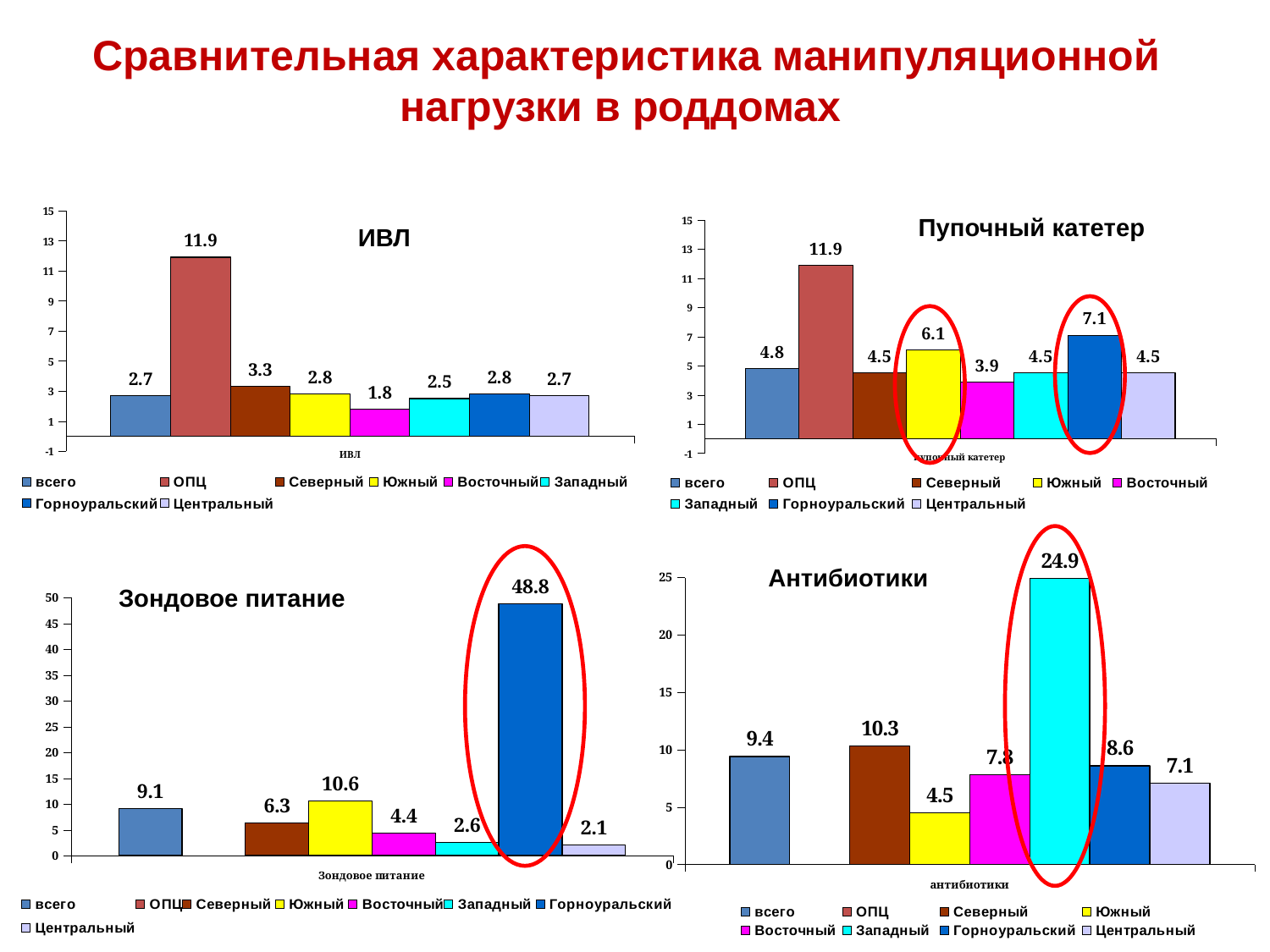
In the Пупочный катетер chart, what is the difference between the values for ОПЦ and всего? 7.1 In the Зондовое питание chart, what is the value for Южный? 10.6 In the Зондовое питание chart, which series has the highest value? Горноуральский In the ИВЛ chart, what is the difference between the values for Северный and Восточный? 1.5 In the Антибиотики chart, what is the value for Западный? 24.9 In the Пупочный катетер chart, which is larger, the value for Южный or the value for Восточный? Южный In the Антибиотики chart, what is the difference between the values for Северный and Южный? 5.8 In the Зондовое питание chart, is the value for Горноуральский greater or less than 45? greater How many series does the legend of the Антибиотики chart list? 8 In the ИВЛ chart, which series has the lowest value? Восточный In the ИВЛ chart, what is the value for ОПЦ? 11.9 In the Пупочный катетер chart, what is the value for Горноуральский? 7.1